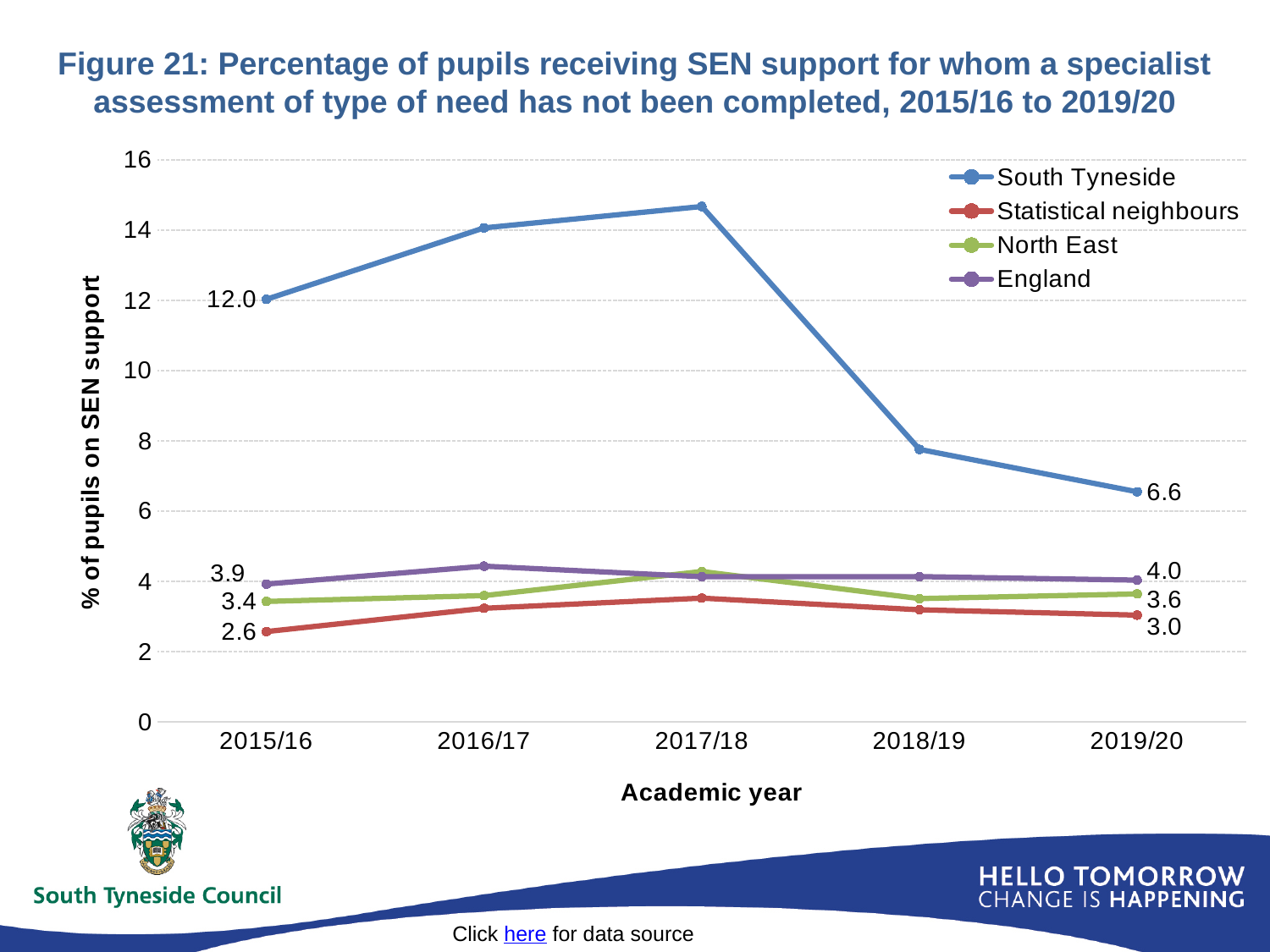
What is the value for South Tyneside in 2019/20? 6.6 How many academic years are plotted on the x axis? 5 What is the value for North East in 2019/20? 3.6 What is the value for South Tyneside in 2015/16? 12.0 By how much did the South Tyneside value fall between 2015/16 and 2019/20? 5.4 Is the value for South Tyneside in 2017/18 greater or less than 14? greater How many series does the legend list? 4 What is the value for Statistical neighbours in 2015/16? 2.6 Which series has the lowest value in 2015/16? Statistical neighbours What is the value for England in 2019/20? 4.0 What type of chart is shown on the slide? line chart Which series has the highest value in 2019/20? South Tyneside